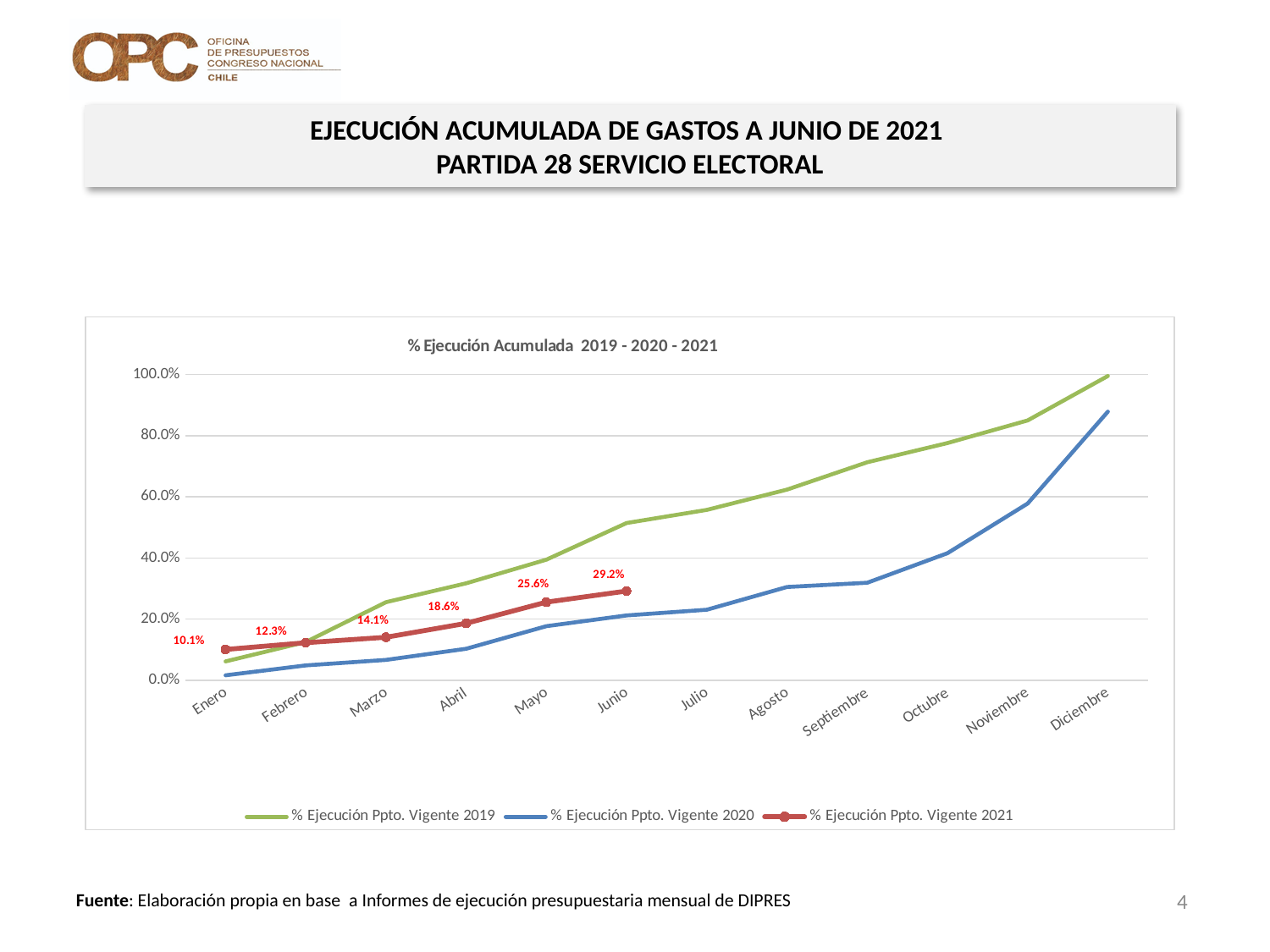
In the % Ejecución Ppto. Vigente 2021 series, which labelled month has the lowest value? Enero In Diciembre, which series has the larger value: % Ejecución Ppto. Vigente 2019 or % Ejecución Ppto. Vigente 2020? % Ejecución Ppto. Vigente 2019 How many series does the legend list? 3 What is the value for Enero in the % Ejecución Ppto. Vigente 2021 series? 10.1% How many months are shown on the x axis? 12 What is the value for Junio in the % Ejecución Ppto. Vigente 2021 series? 29.2% Is the value for Diciembre in the % Ejecución Ppto. Vigente 2020 series greater or less than 80%? greater What kind of chart is shown on the slide? Line chart What is the difference in percentage points between Junio and Enero in the % Ejecución Ppto. Vigente 2021 series? 19.1 percentage points What is the value for Abril in the % Ejecución Ppto. Vigente 2021 series? 18.6% Do the values of the % Ejecución Ppto. Vigente 2021 series rise or fall from Enero to Junio? Rise In the % Ejecución Ppto. Vigente 2021 series, which labelled month has the highest value? Junio